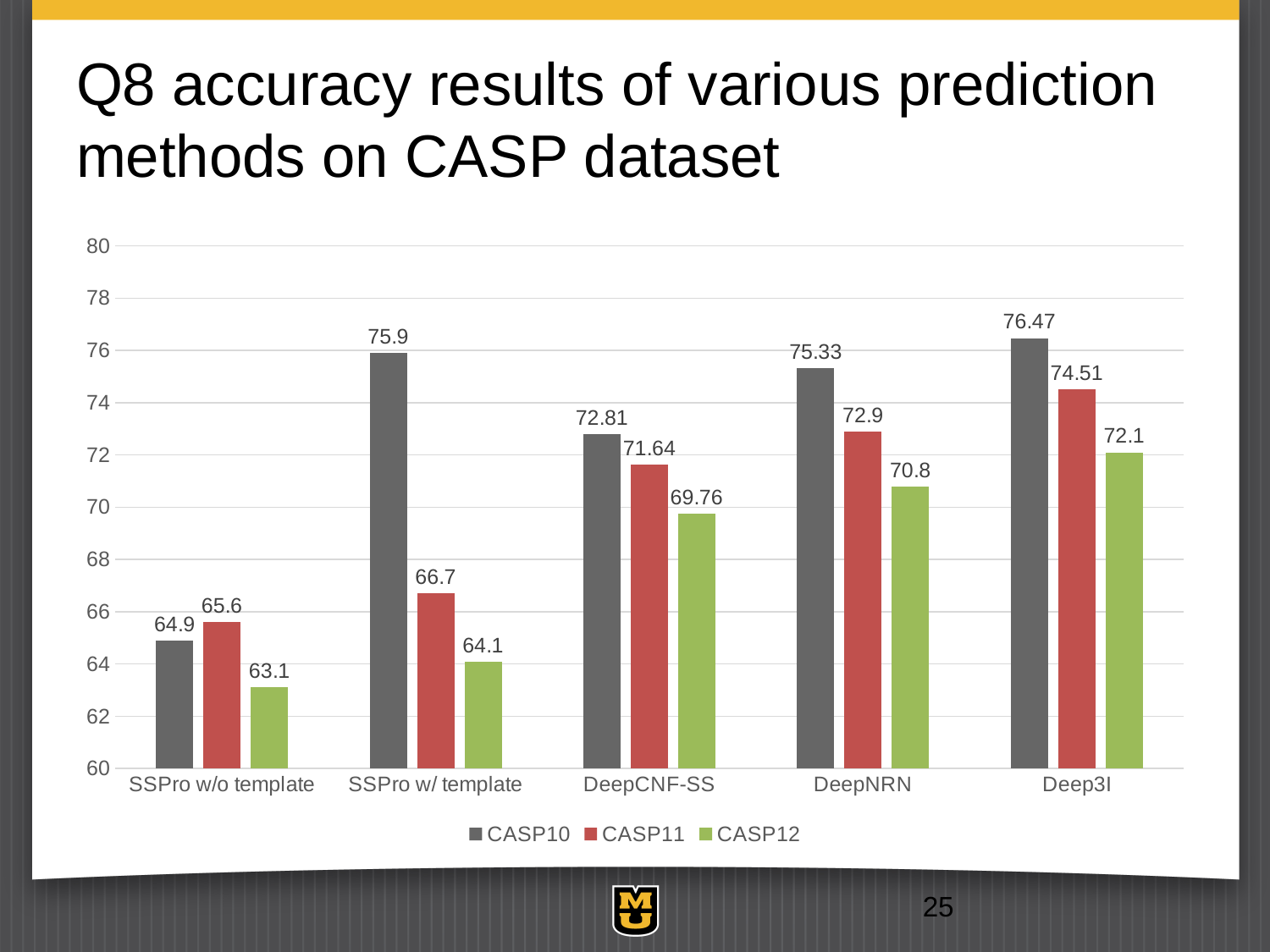
What kind of chart is shown on the slide? bar chart Which method has the lowest CASP12 value? SSPro w/o template What is the CASP11 value for SSPro w/ template? 66.7 Which method has the highest CASP10 value? Deep3I What is the CASP12 value for DeepCNF-SS? 69.76 Which is larger, the CASP11 value for DeepNRN or the CASP11 value for DeepCNF-SS? DeepNRN Is the CASP12 value for DeepNRN greater or less than 70? greater How many series does the legend list? 3 What is the difference between the CASP10 and CASP11 values for SSPro w/ template? 9.2 What is the CASP10 value for Deep3I? 76.47 How many prediction methods are shown on the x axis? 5 Which series is shown in green in the legend? CASP12